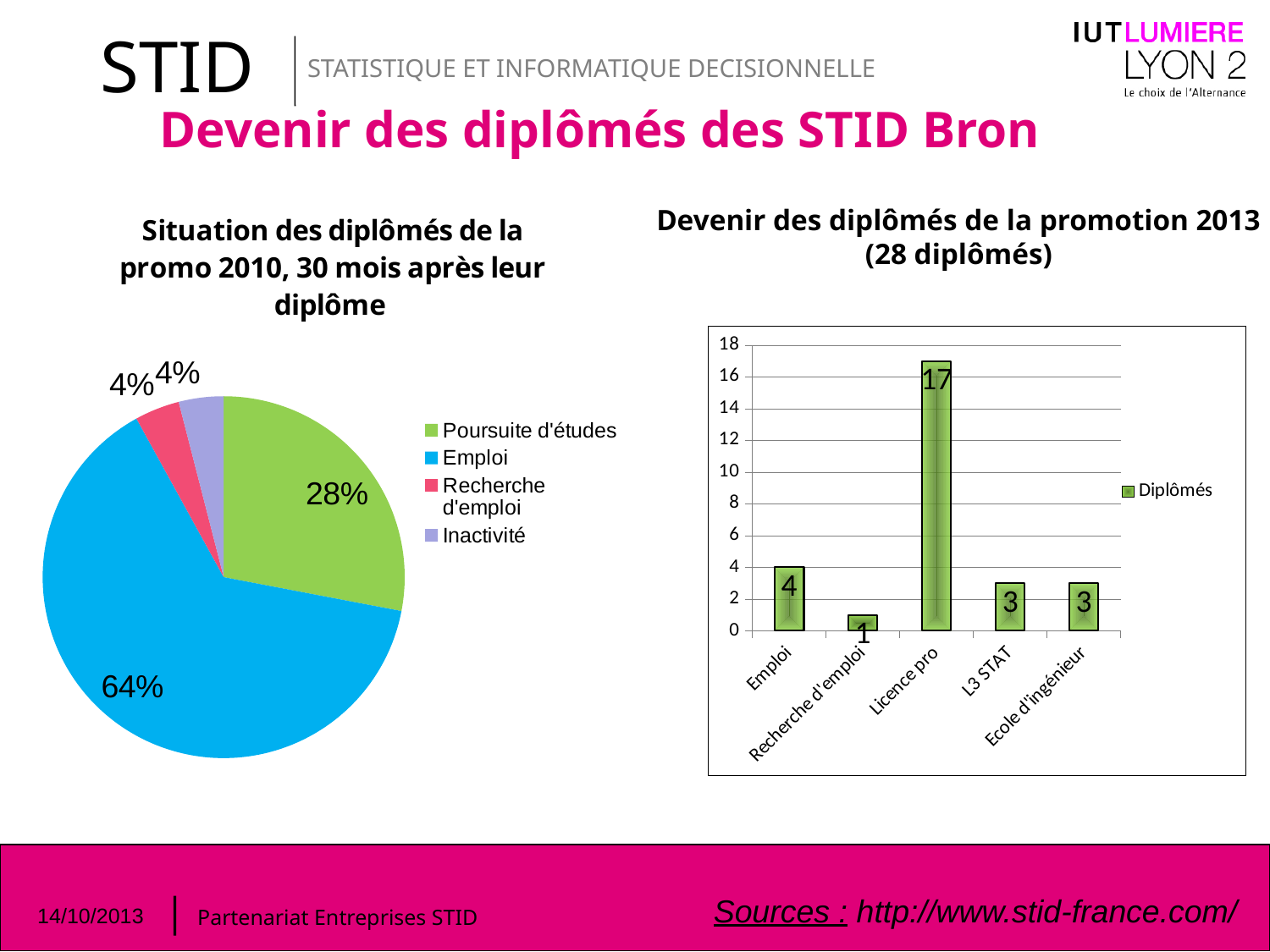
In the bar chart on the right, how many categories are shown on the x axis? 5 In the bar chart on the right, how many graduates are in 'Licence pro'? 17 In the pie chart on the left, what share of the 2010 graduates are in 'Poursuite d'études'? 28% In the pie chart on the left, what is the difference in percentage points between 'Emploi' and 'Poursuite d'études'? 36 In the pie chart on the left, which category has the largest share? Emploi In the bar chart on the right, which category has the lowest value? Recherche d'emploi In the bar chart on the right, how many graduates are in 'Emploi'? 4 In the pie chart on the left, how many categories does the legend list? 4 What type of chart is the chart on the right? Bar chart In the bar chart on the right, which category has the highest value? Licence pro In the pie chart on the left, what share of the 2010 graduates are in 'Emploi'? 64% In the bar chart on the right, what is the difference between 'Licence pro' and 'Emploi'? 13